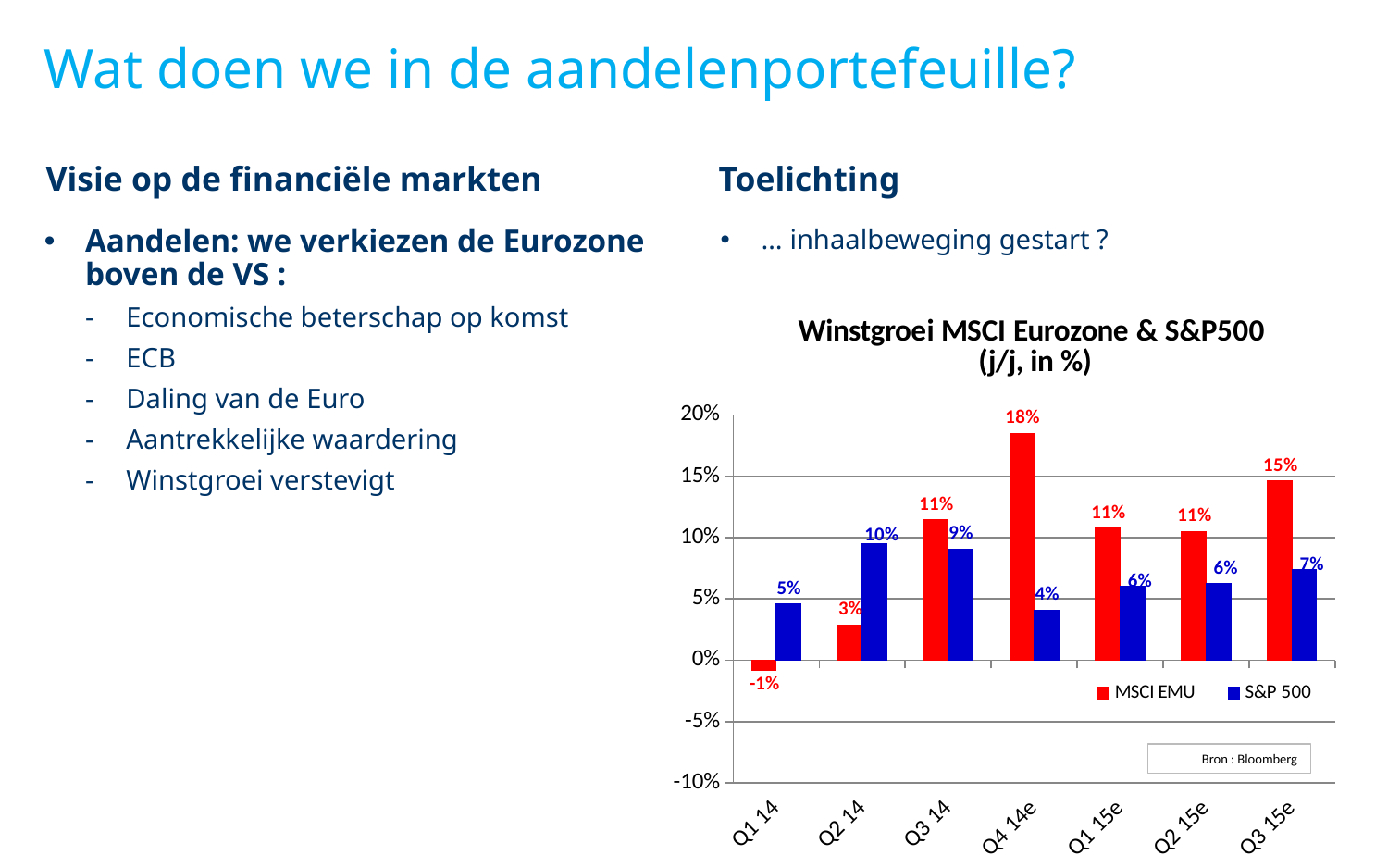
Which series has the larger value in Q2 14, MSCI EMU or S&P 500? S&P 500 How many quarters are shown on the x axis? 7 What kind of chart is shown? Bar chart How many series does the legend list? 2 What is the S&P 500 value for Q2 14? 10% In which quarter is the S&P 500 value lowest? Q4 14e What is the S&P 500 value for Q3 15e? 7% In which quarter is the MSCI EMU value highest? Q4 14e What is the MSCI EMU value for Q4 14e? 18% What is the title of the chart? Winstgroei MSCI Eurozone & S&P500 (j/j, in %) What is the difference between the MSCI EMU and S&P 500 values in Q4 14e? 14% What is the MSCI EMU value for Q1 14? -1%